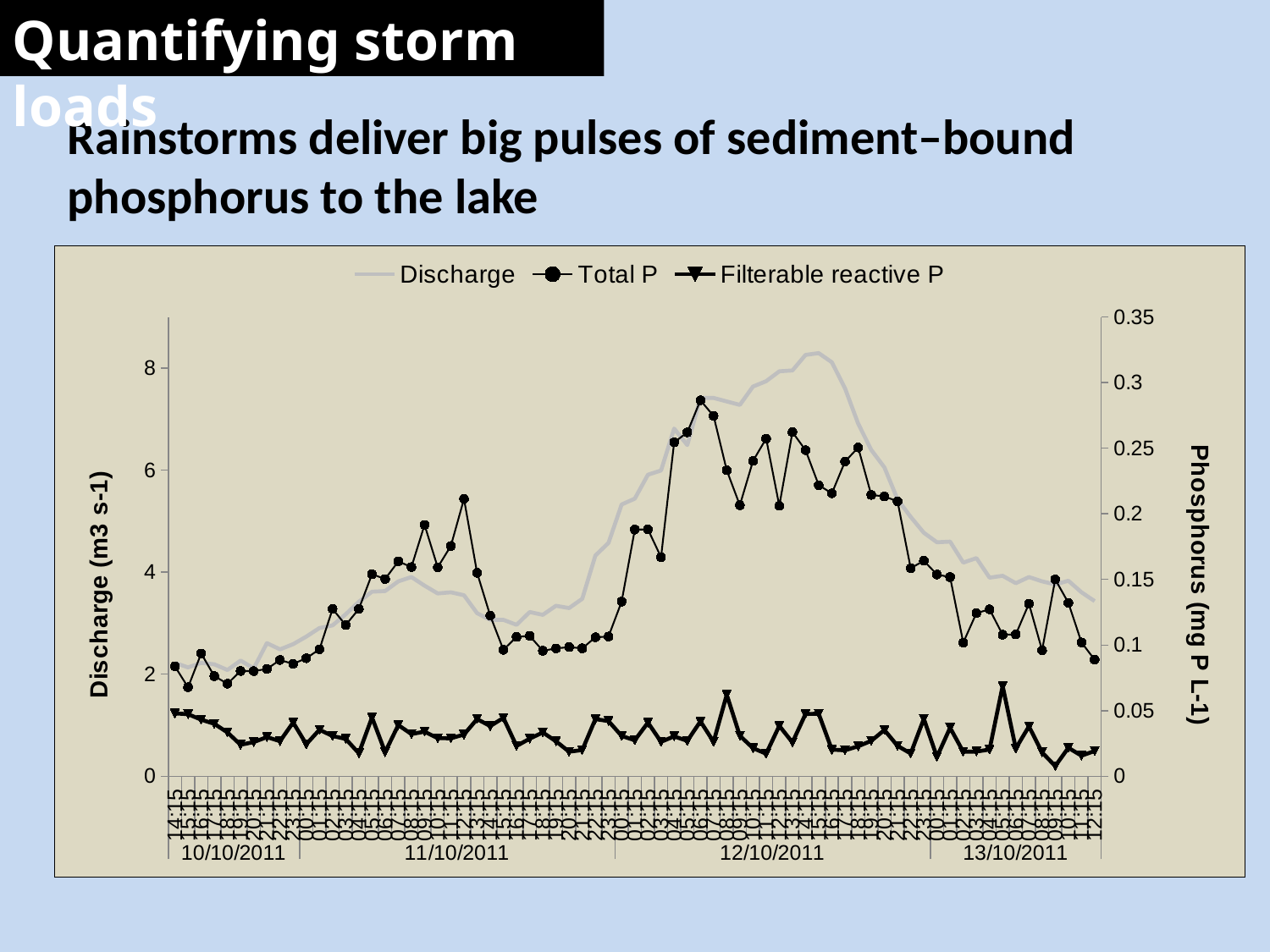
Is the Discharge value at the start of the chart (10/10/2011) greater or less than 4 m3 s-1? less Is the highest value of the Filterable reactive P series greater or less than 0.1 mg P L-1? less Does the Discharge series rise or fall between 11/10/2011 and 12/10/2011? Rise Is the peak value of the Total P series greater or less than 0.25 mg P L-1? greater What is the title of the left vertical axis of the chart? Discharge (m3 s-1) What kind of chart is shown on the slide? Line chart Does the Discharge series rise or fall between 12/10/2011 and 13/10/2011? Fall How many dates are labelled along the x axis of the chart? 4 Which series reaches higher values on the phosphorus axis, Total P or Filterable reactive P? Total P What are the three series named in the chart legend? Discharge, Total P, Filterable reactive P How many series does the chart legend list? 3